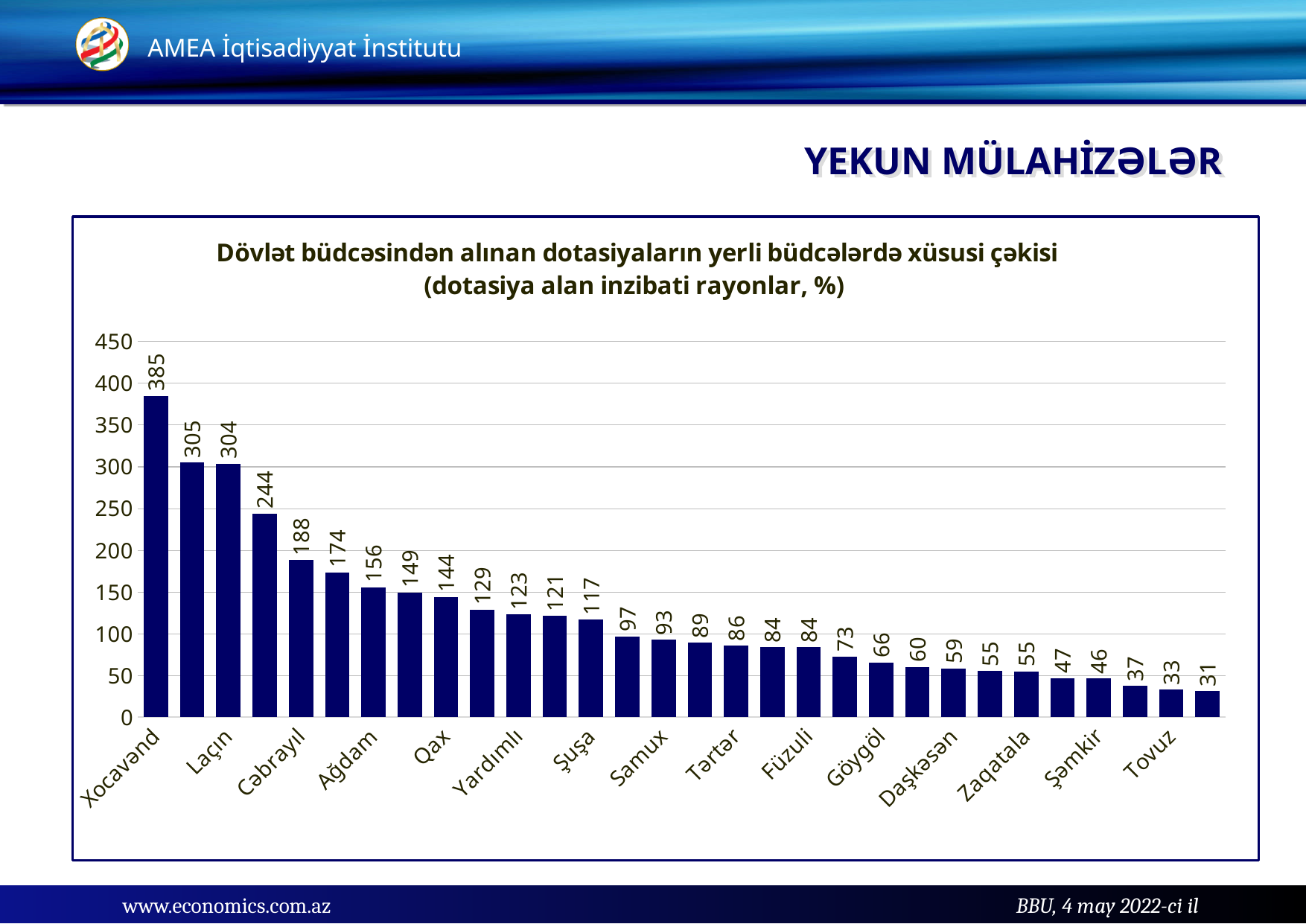
Is the value for Tovuz greater or less than 50? less Is the value for Xocavənd greater or less than 350? greater What colour are the bars in the chart? dark blue How many bars are plotted in the chart? 30 What is the value for Xocavənd? 385 What kind of chart is shown on the slide? bar chart What is the highest value shown in the chart? 385 What is the value for Cəbrayıl? 188 What is the lowest value shown in the chart? 31 Which is larger, the value for Xocavənd or the value for Tovuz? Xocavənd Which category has the highest value in the chart? Xocavənd Do the values rise or fall from left to right along the x axis? fall